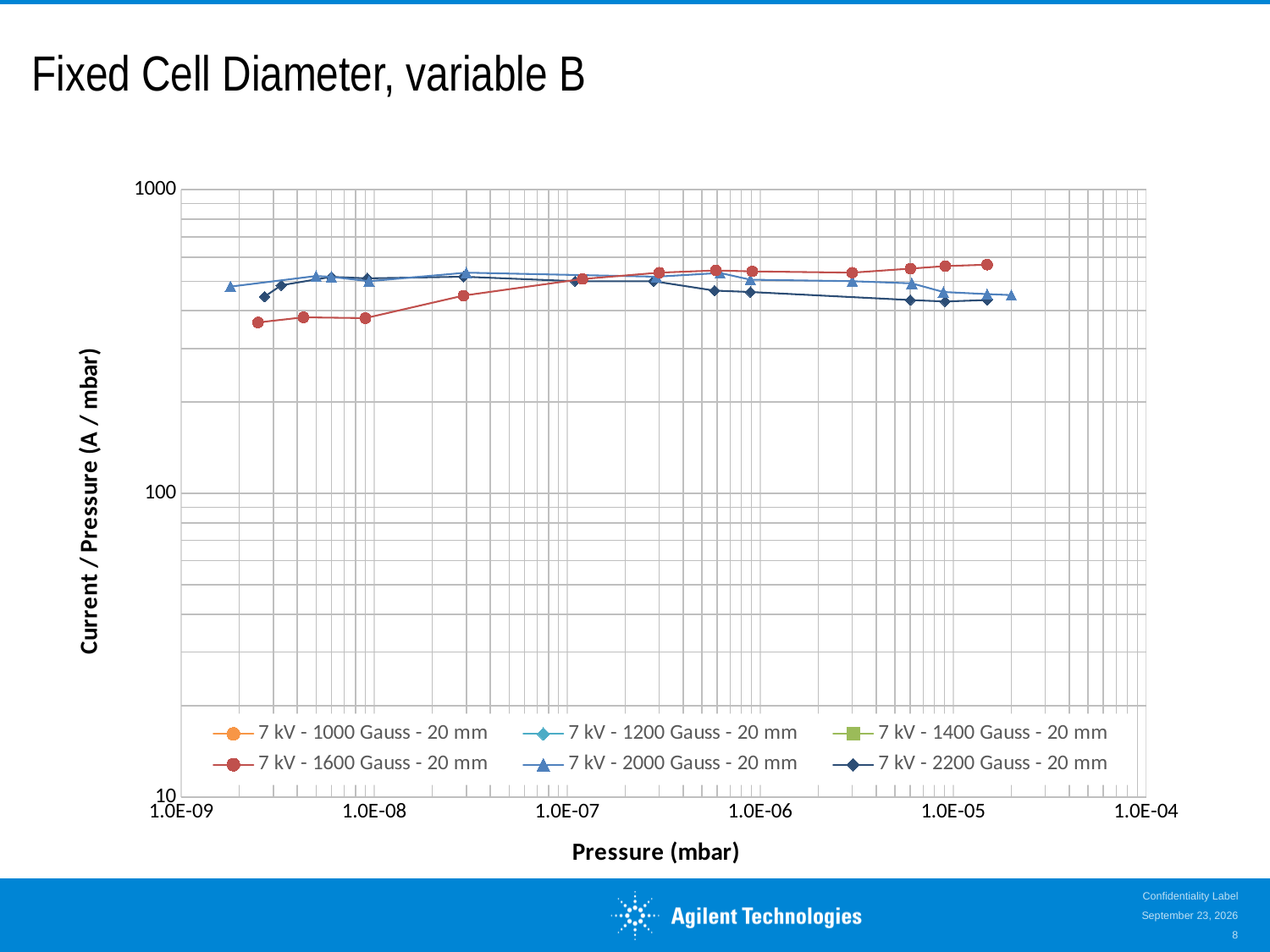
What is the title of the slide containing the chart? Fixed Cell Diameter, variable B Do the values of the 7 kV - 2200 Gauss - 20 mm series generally rise or fall between 1.0E-07 mbar and 1.0E-05 mbar? fall At a pressure of 1.0E-08 mbar, which series has the larger value: 7 kV - 1600 Gauss - 20 mm or 7 kV - 2000 Gauss - 20 mm? 7 kV - 2000 Gauss - 20 mm Is the value for the 7 kV - 2000 Gauss - 20 mm series at a pressure of 1.0E-05 mbar greater or less than 1000? less What kind of chart is shown on the slide? line chart Do the values of the 7 kV - 1600 Gauss - 20 mm series generally rise or fall as pressure increases along the x axis? rise At a pressure of 1.0E-05 mbar, which series has the larger value: 7 kV - 1600 Gauss - 20 mm or 7 kV - 2200 Gauss - 20 mm? 7 kV - 1600 Gauss - 20 mm Which series reaches the highest value on the chart? 7 kV - 1600 Gauss - 20 mm What is the label of the x axis? Pressure (mbar) Is the value for the 7 kV - 1600 Gauss - 20 mm series at a pressure of 1.0E-08 mbar greater or less than 100? greater Is the value for the 7 kV - 2200 Gauss - 20 mm series at a pressure of 1.0E-06 mbar greater or less than 100? greater How many series does the legend list? 6